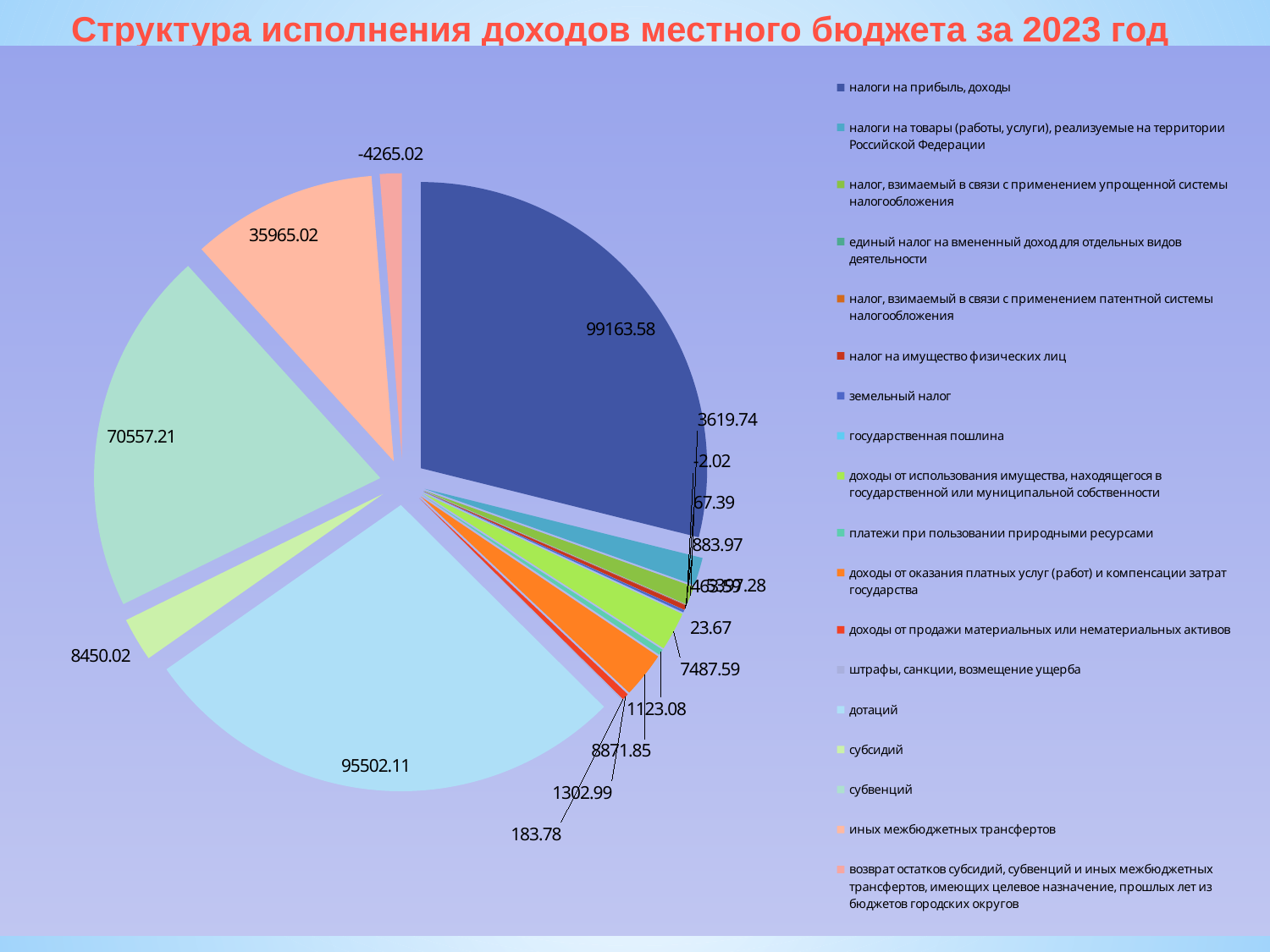
Which is larger, the value for дотаций or the value for субвенций? дотаций What kind of chart is shown on the slide? pie chart What is the difference between the value for субвенций and the value for иных межбюджетных трансфертов? 34592.19 Which category has the largest slice of the pie? налоги на прибыль, доходы What is the value shown for субсидий? 8450.02 What is the value of the largest slice of the pie? 99163.58 What is the value shown for возврат остатков субсидий, субвенций и иных межбюджетных трансфертов? -4265.02 How many entries does the chart's legend list? 18 What is the value shown for иных межбюджетных трансфертов? 35965.02 What is the value shown for субвенций? 70557.21 What is the value shown for дотаций? 95502.11 What is the title of the chart on the slide? Структура исполнения доходов местного бюджета за 2023 год